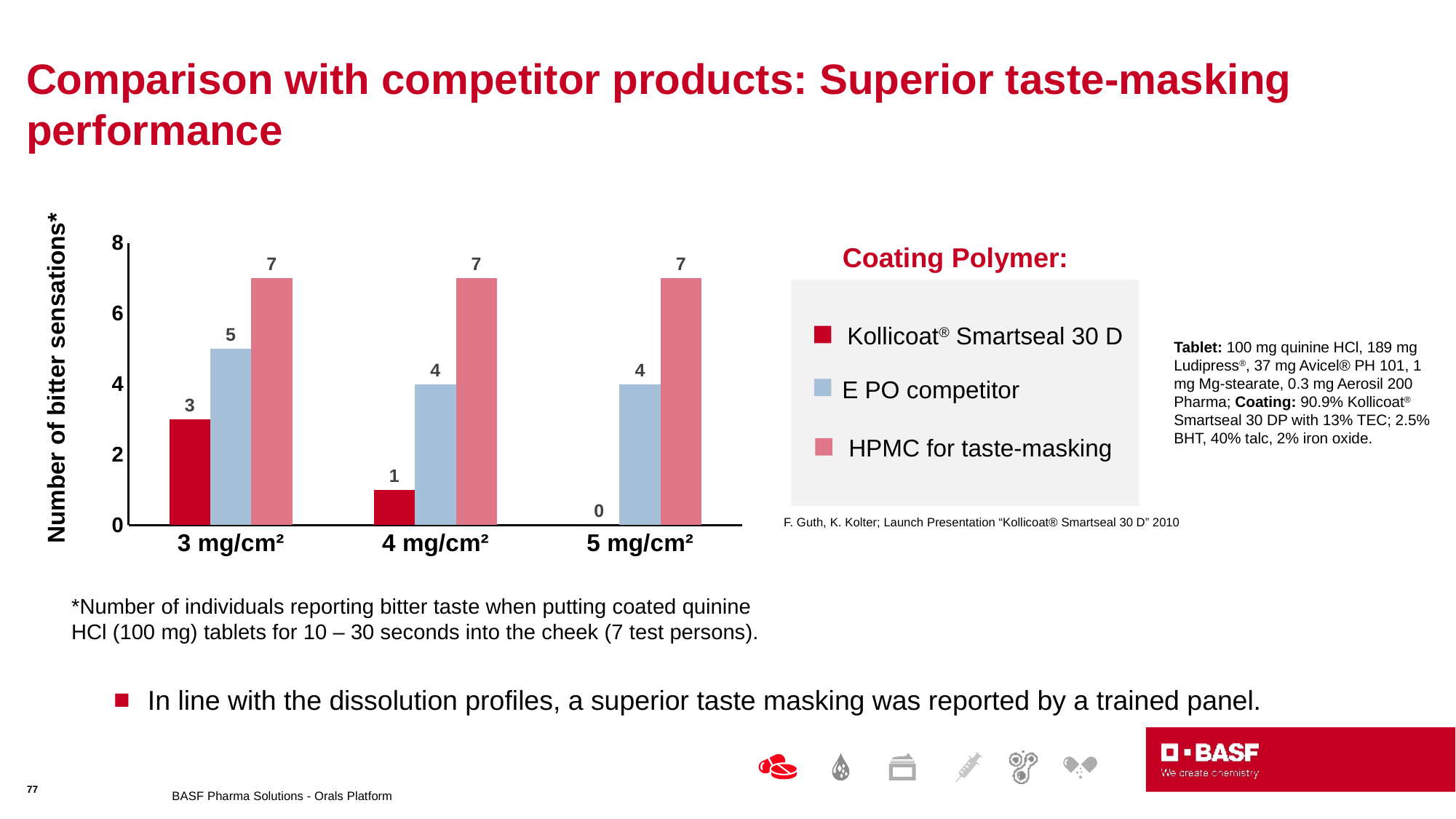
How does the number of bitter sensations for Kollicoat Smartseal 30 D change as the coating level increases from 3 to 5 mg/cm²? It falls Which coating polymer has the highest number of bitter sensations at 3 mg/cm²? HPMC for taste-masking How many coating levels (categories) are shown on the x axis? 3 What kind of chart is shown on the slide? Bar chart Which is larger at 4 mg/cm²: the value for E PO competitor or for HPMC for taste-masking? HPMC for taste-masking How many series does the legend list? 3 What is the difference between the E PO competitor and Kollicoat Smartseal 30 D values at 3 mg/cm²? 2 Which coating polymer has the lowest number of bitter sensations at 4 mg/cm²? Kollicoat Smartseal 30 D What is the number of bitter sensations for HPMC for taste-masking at 5 mg/cm²? 7 What is the number of bitter sensations for Kollicoat Smartseal 30 D at 3 mg/cm²? 3 What is the number of bitter sensations for Kollicoat Smartseal 30 D at 5 mg/cm²? 0 What is the number of bitter sensations for E PO competitor at 4 mg/cm²? 4